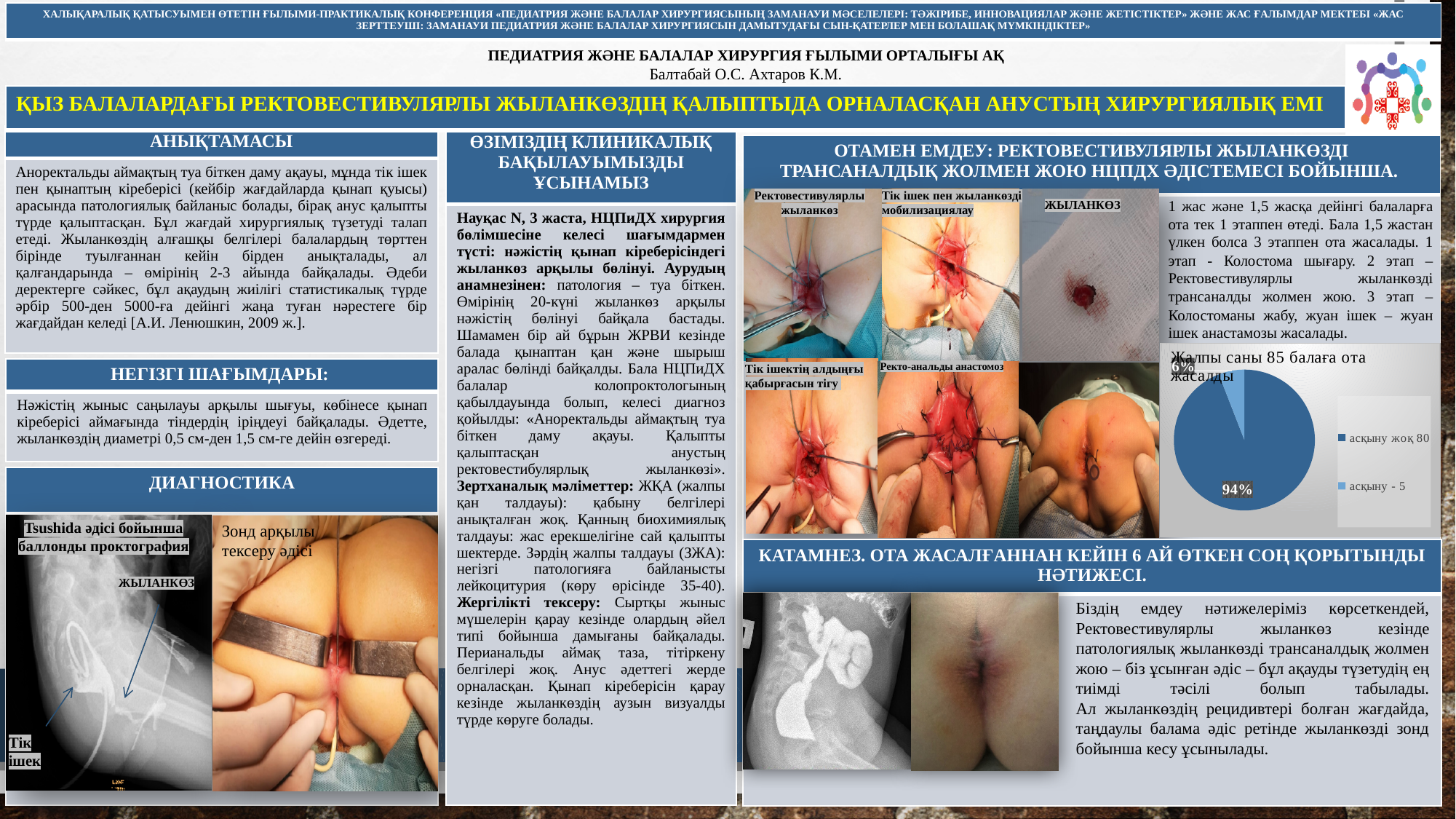
Which is larger in the pie chart: 'асқыну жоқ 80' or 'асқыну - 5'? асқыну жоқ 80 What percentage is shown for the 'асқыну - 5' slice of the pie chart? 6% What kind of chart is shown on the slide? pie chart How many slices does the pie chart have? 2 How many entries does the pie chart legend list? 2 What is the title of the pie chart? Жалпы саны 85 балаға ота жасалды What is the total number of children stated in the pie chart title? 85 What percentage is shown for the 'асқыну жоқ 80' slice of the pie chart? 94% Which slice of the pie chart is the largest? асқыну жоқ 80 What is the difference in percentage points between the 'асқыну жоқ 80' and 'асқыну - 5' slices of the pie chart? 88 Which slice of the pie chart is the smallest? асқыну - 5